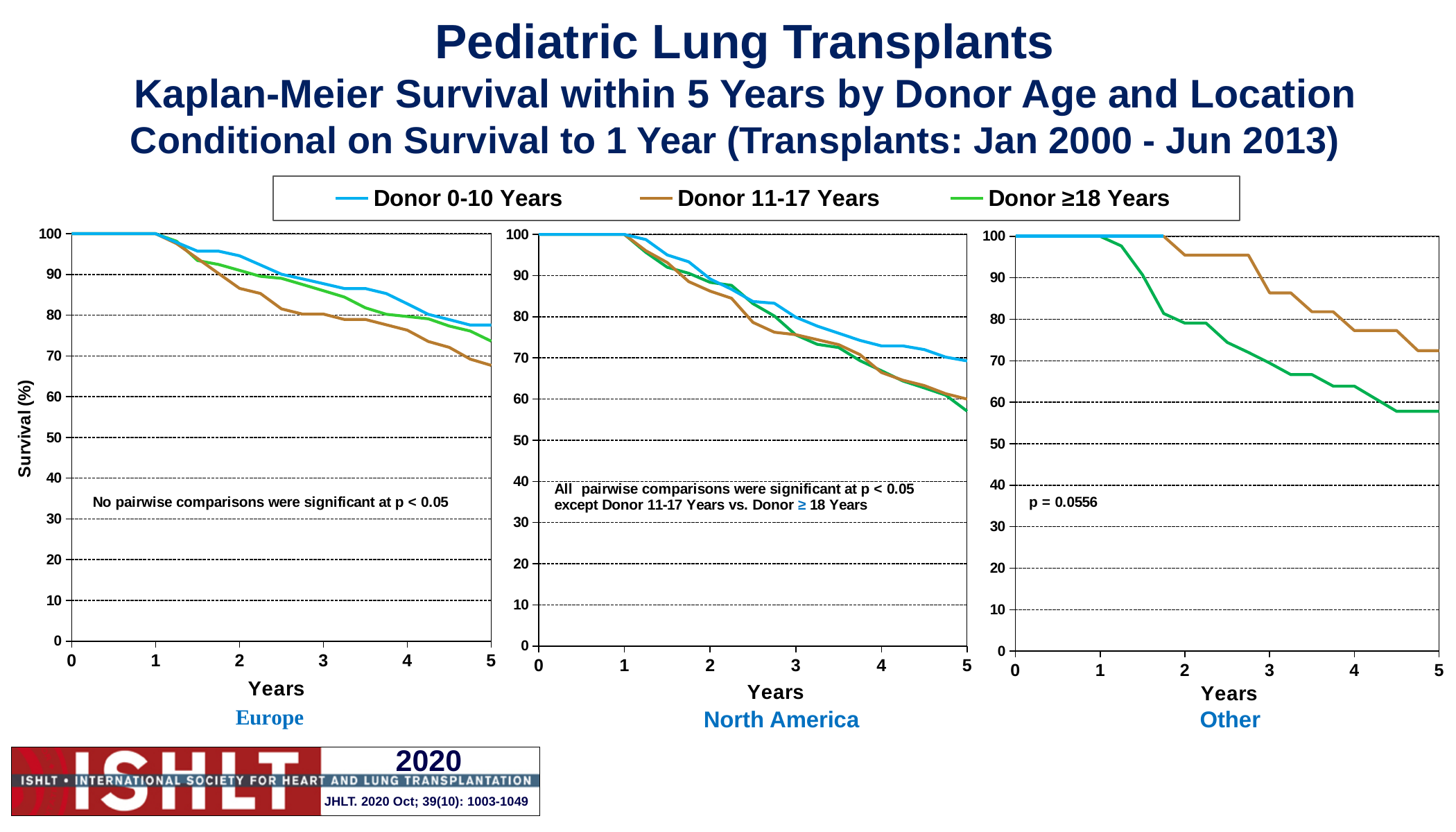
In the Other chart, is the survival for Donor ≥18 Years at 5 years greater or less than 60? less How many series does the legend list? 3 How many charts are shown on the slide? 3 In the Other chart, which has higher survival at 5 years: Donor 11-17 Years or Donor ≥18 Years? Donor 11-17 Years In the Europe chart, is the survival for Donor 0-10 Years at 5 years greater or less than 70? greater In the North America chart, do the survival curves rise or fall as years increase? Fall In the Europe chart, which has higher survival at 5 years: Donor 0-10 Years or Donor 11-17 Years? Donor 0-10 Years In the North America chart, which has higher survival at 5 years: Donor 0-10 Years or Donor ≥18 Years? Donor 0-10 Years In the Other chart, is the survival for Donor 11-17 Years at 5 years greater or less than 80? less What p-value is printed on the Other chart? p = 0.0556 What kind of chart is the Europe chart? Line chart